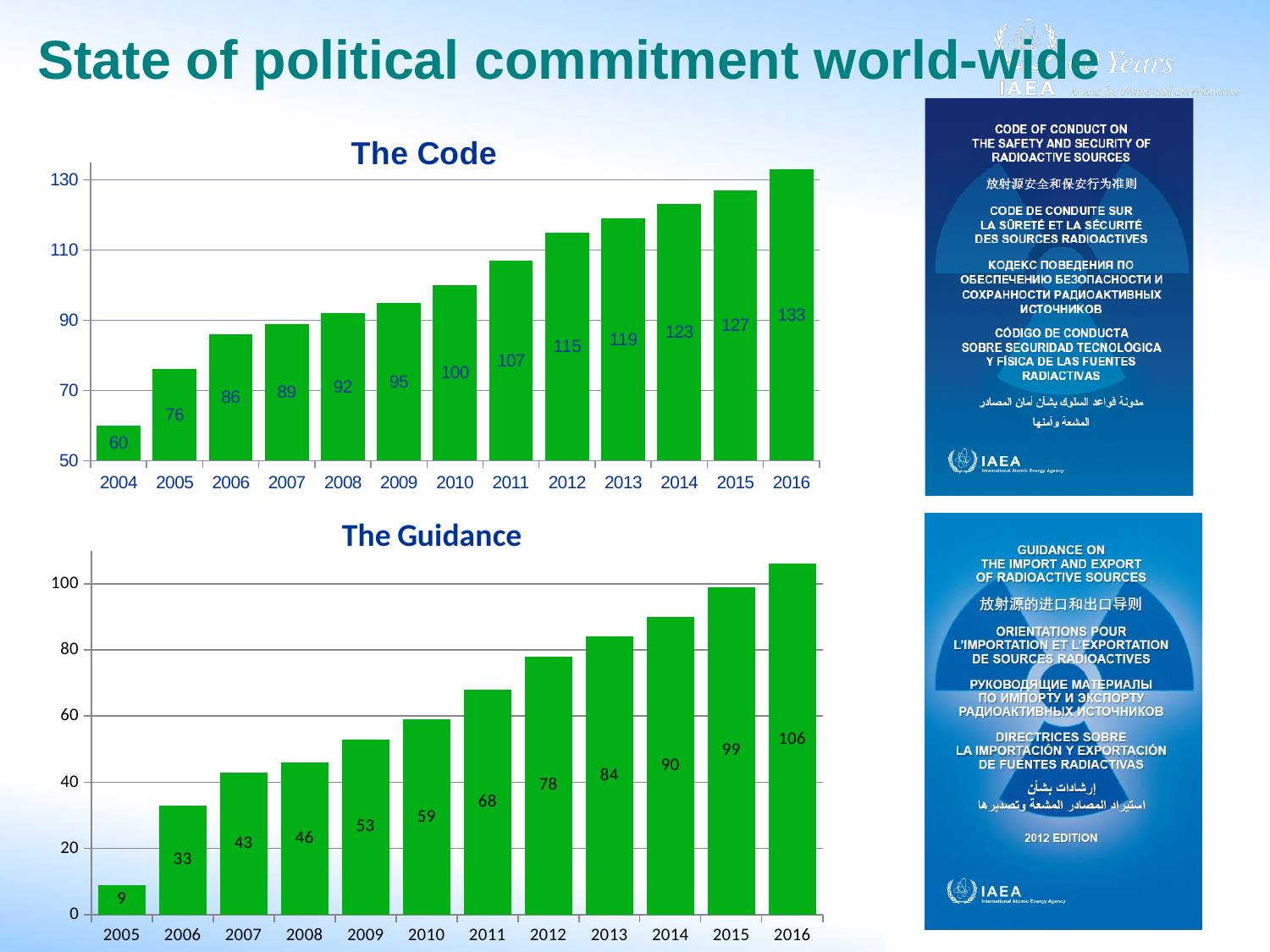
In the chart titled "The Guidance", what is the difference between the values for 2016 and 2015? 7 In the chart titled "The Code", what is the difference between the values for 2016 and 2004? 73 What kind of chart is the chart titled "The Guidance"? Bar chart In the chart titled "The Guidance", is the value for 2014 greater or less than 80? greater In the chart titled "The Guidance", which year has the lowest value? 2005 In the chart titled "The Code", which is larger, the value for 2008 or the value for 2012? 2012 In the chart titled "The Code", what is the value for 2010? 100 In the chart titled "The Code", which year has the highest value? 2016 In the chart titled "The Guidance", what is the value for 2012? 78 In the chart titled "The Code", do the values rise or fall from 2004 to 2016? Rise How many years are shown on the x axis of the chart titled "The Guidance"? 12 How many years are shown on the x axis of the chart titled "The Code"? 13